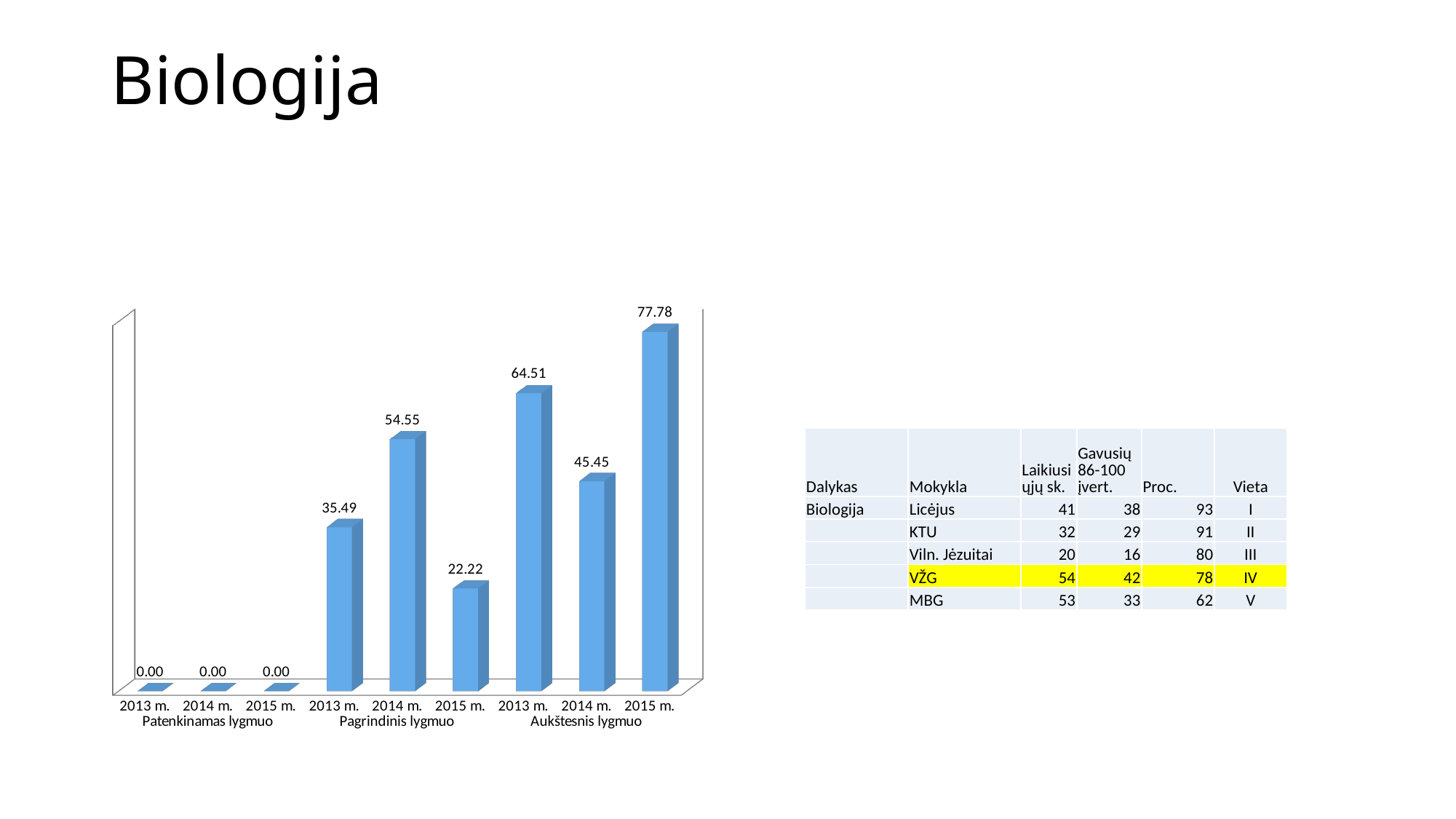
What value is shown for all three years in the Patenkinamas lygmuo group? 0.00 What is the value for 2015 m. in the Aukštesnis lygmuo group? 77.78 How many bars are plotted on the chart? 9 What is the value for 2013 m. in the Aukštesnis lygmuo group? 64.51 Which bar has the highest value on the chart? 2015 m., Aukštesnis lygmuo What is the difference between the 2014 m. values of Pagrindinis lygmuo and Aukštesnis lygmuo? 9.10 Which is larger: the 2013 m. value for Pagrindinis lygmuo or the 2014 m. value for Aukštesnis lygmuo? 2014 m. Aukštesnis lygmuo What is the value for 2014 m. in the Pagrindinis lygmuo group? 54.55 What kind of chart is shown on the slide? Bar chart What is the value for 2015 m. in the Pagrindinis lygmuo group? 22.22 Within the Pagrindinis lygmuo group, which year has the lowest value? 2015 m. What is the difference between the 2015 m. and 2013 m. values in the Aukštesnis lygmuo group? 13.27